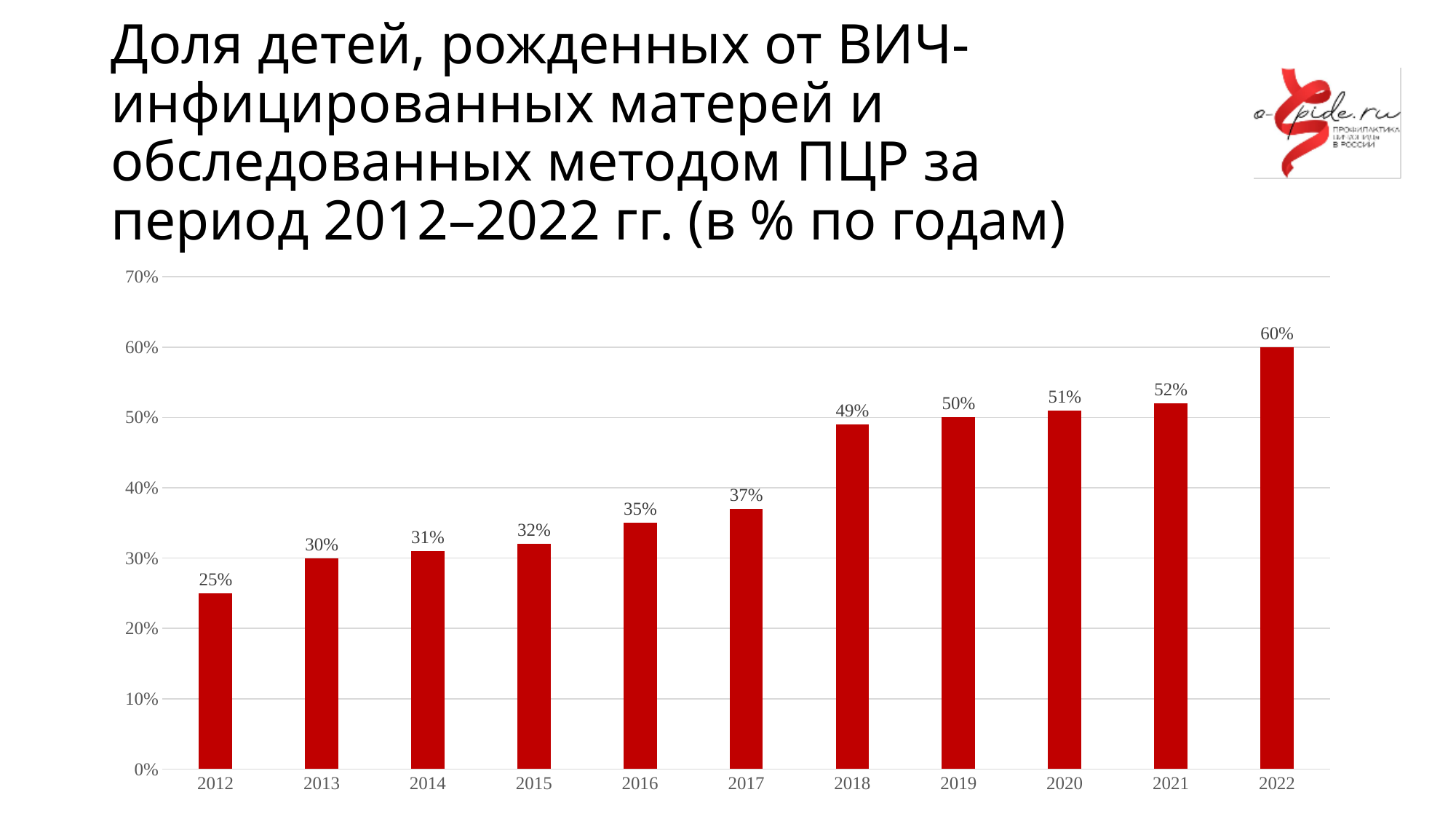
How many years are shown on the x axis? 11 What is the difference between the values for 2022 and 2012? 35% Which year has the highest value? 2022 Do the values rise or fall from 2012 to 2022? rise Which year has the lowest value? 2012 What is the difference between the values for 2018 and 2017? 12% What is the value for 2012? 25% What is the value for 2018? 49% What kind of chart is this? bar chart What is the value for 2022? 60% Is the value for 2017 greater or less than 40%? less Which is larger, the value for 2016 or the value for 2019? 2019